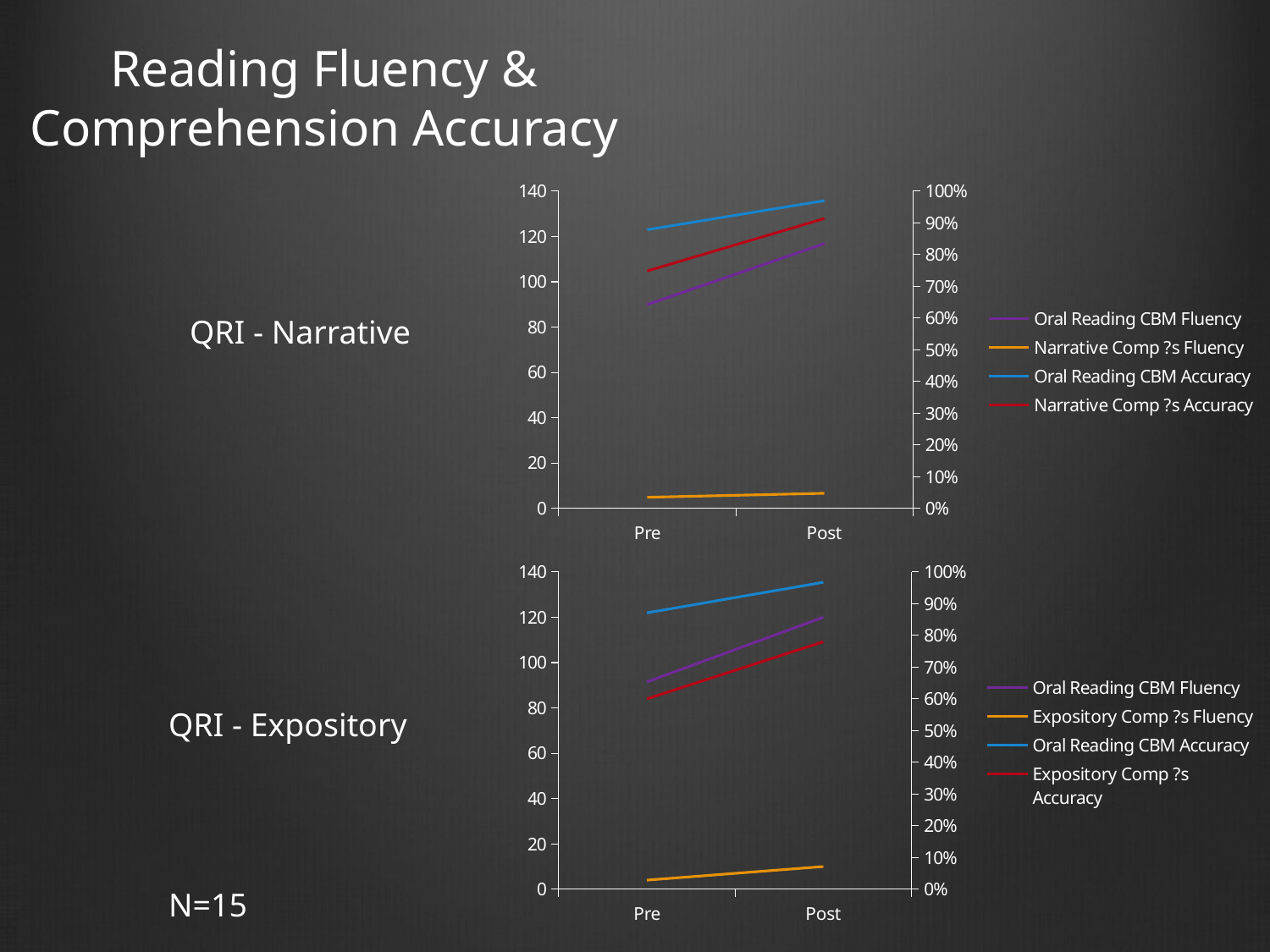
In the QRI - Expository chart, is the Oral Reading CBM Fluency value at Post greater or less than 100 on the left axis? greater In the QRI - Expository chart, which series is plotted lowest across both Pre and Post? Expository Comp ?s Fluency What kind of chart is the QRI - Narrative chart? line chart In the QRI - Narrative chart, is the Narrative Comp ?s Fluency value at Pre greater or less than 20 on the left axis? less What is the maximum value shown on the right-hand axis of the QRI - Expository chart? 100% How many series does the legend of the QRI - Expository chart list? 4 What are the two x-axis category labels on the QRI - Narrative chart? Pre and Post How many series does the legend of the QRI - Narrative chart list? 4 In the QRI - Narrative chart, which series is plotted highest at Post? Oral Reading CBM Accuracy How many categories are on the x axis of the QRI - Expository chart? 2 In the QRI - Expository chart, does the Expository Comp ?s Accuracy line rise or fall from Pre to Post? rise In the QRI - Narrative chart, does the Oral Reading CBM Fluency line rise or fall from Pre to Post? rise